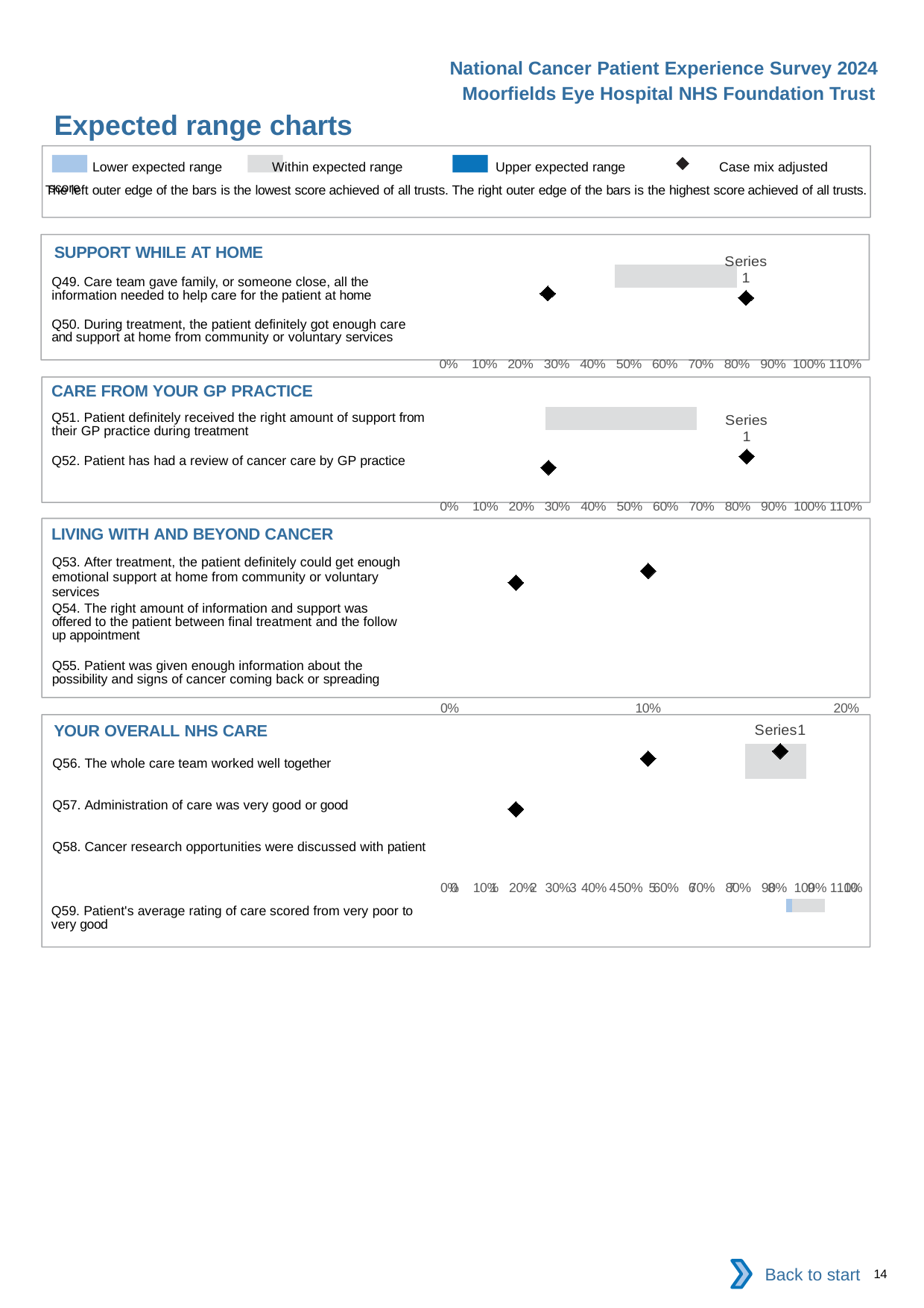
In the SUPPORT WHILE AT HOME chart, is the leftmost diamond marker greater or less than 50%? less In the SUPPORT WHILE AT HOME chart, is the rightmost diamond marker greater or less than 70%? greater In the CARE FROM YOUR GP PRACTICE chart, is the leftmost diamond marker greater or less than 50%? less What is the highest tick label on the x axis of the SUPPORT WHILE AT HOME chart? 110% In the CARE FROM YOUR GP PRACTICE chart, which diamond marker is further right, the one near the Q52 row or the one below the Series 1 label? the one below the Series 1 label In the SUPPORT WHILE AT HOME chart, how many case mix adjusted score diamonds are plotted? 2 In the CARE FROM YOUR GP PRACTICE chart, how many diamond markers are plotted? 2 In the LIVING WITH AND BEYOND CANCER chart, how many diamond markers are plotted? 2 How many entries does the legend at the top of the slide list? 4